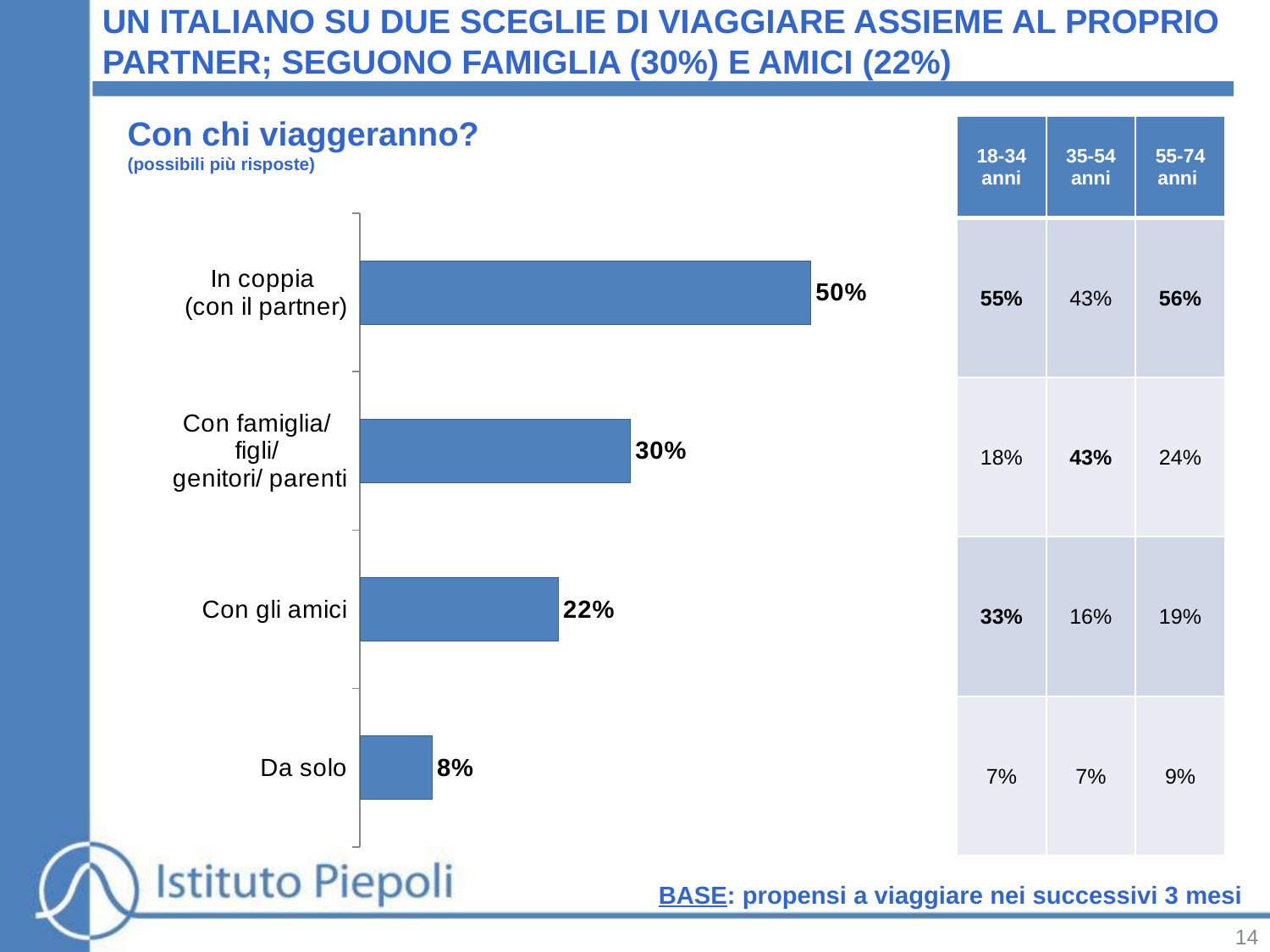
What is the value for "Con gli amici"? 22% What is the title of the chart? Con chi viaggeranno? What is the difference between the values for "Con gli amici" and "Da solo"? 14% Which category has the lowest value? Da solo Which is larger, the value for "Con famiglia/ figli/ genitori/ parenti" or the value for "Con gli amici"? Con famiglia/ figli/ genitori/ parenti What kind of chart is shown on the slide? Bar chart Which category has the highest value? In coppia (con il partner) What is the difference between the values for "In coppia (con il partner)" and "Con famiglia/ figli/ genitori/ parenti"? 20% What is the value for "Da solo"? 8% How many categories does the chart show? 4 What is the value for "Con famiglia/ figli/ genitori/ parenti"? 30% What is the value for "In coppia (con il partner)"? 50%